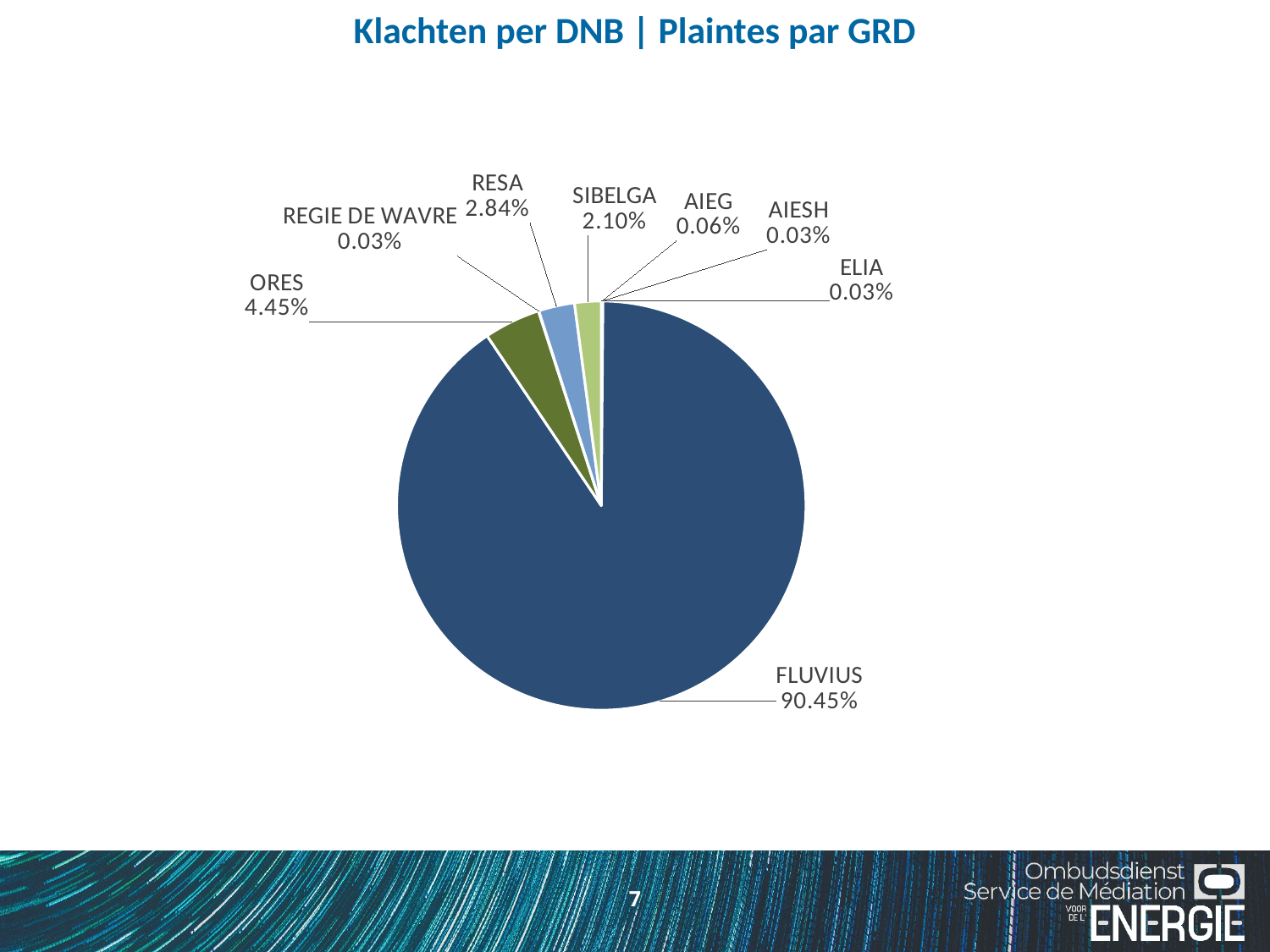
Which category has the largest slice of the pie? FLUVIUS Which is larger, the slice for ORES or the slice for RESA? ORES What is the value shown for SIBELGA? 2.10% What kind of chart is shown on the slide? Pie chart What is the title of the chart on the slide? Klachten per DNB | Plaintes par GRD What share of the pie does FLUVIUS have? 90.45% What is the value shown for AIEG? 0.06% How many categories are shown in the pie chart? 8 What is the value shown for ORES? 4.45% What is the value shown for RESA? 2.84% Is the value for FLUVIUS greater or less than 50%? greater What is the difference between the values for ORES and SIBELGA? 2.35%